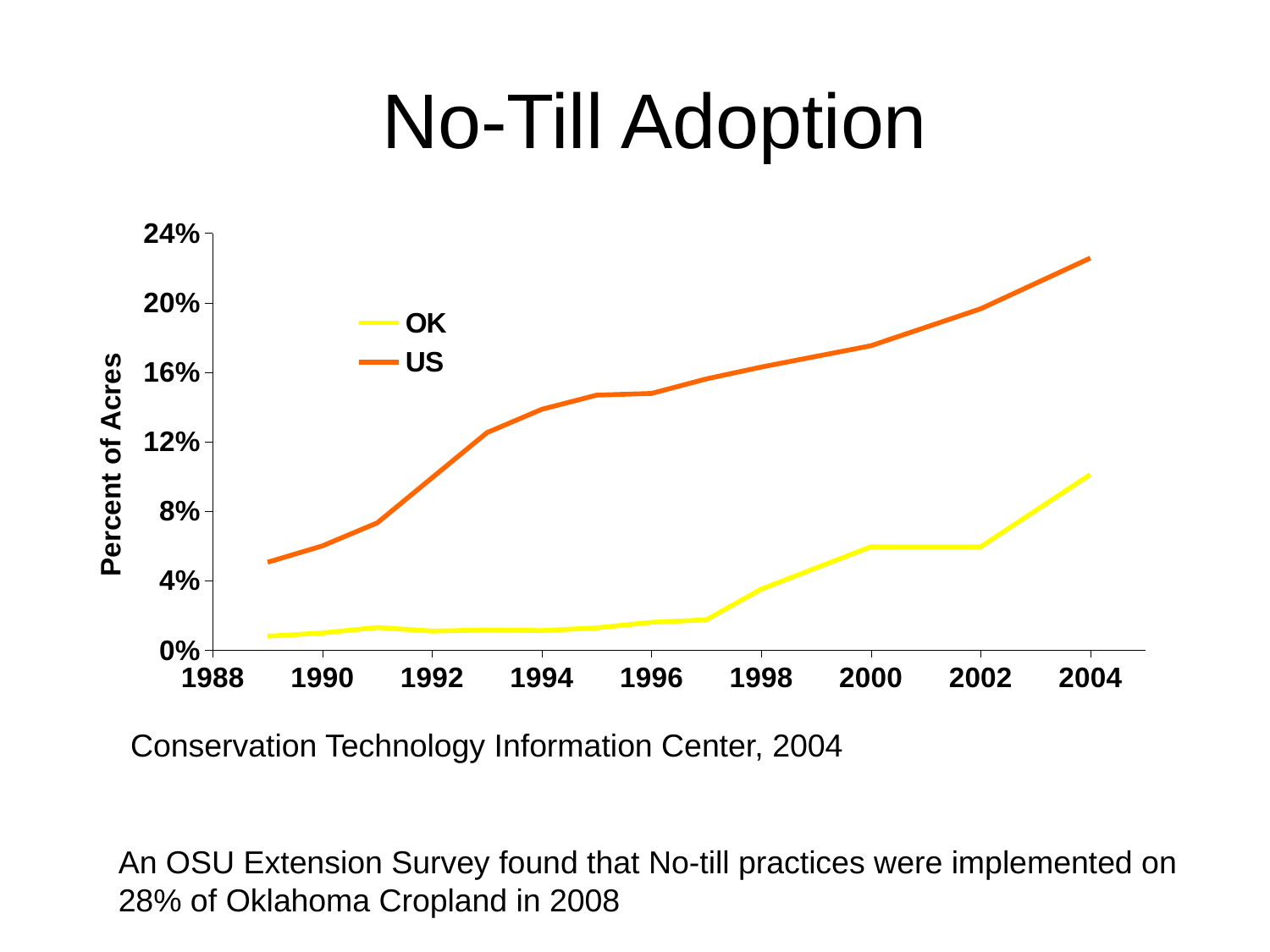
What is the label on the vertical axis? Percent of Acres What kind of chart is shown on the slide? line chart Is the value for OK in 2000 greater or less than 4%? greater Is the value for OK in 1996 greater or less than 4%? less Does the US line rise or fall from 1989 to 2004? rise Is the value for OK in 2004 greater or less than 8%? greater Which series has the higher value in 2004, OK or US? US How many series does the legend list? 2 Which series has the lower value in 1989, OK or US? OK What is the title of the chart? No-Till Adoption